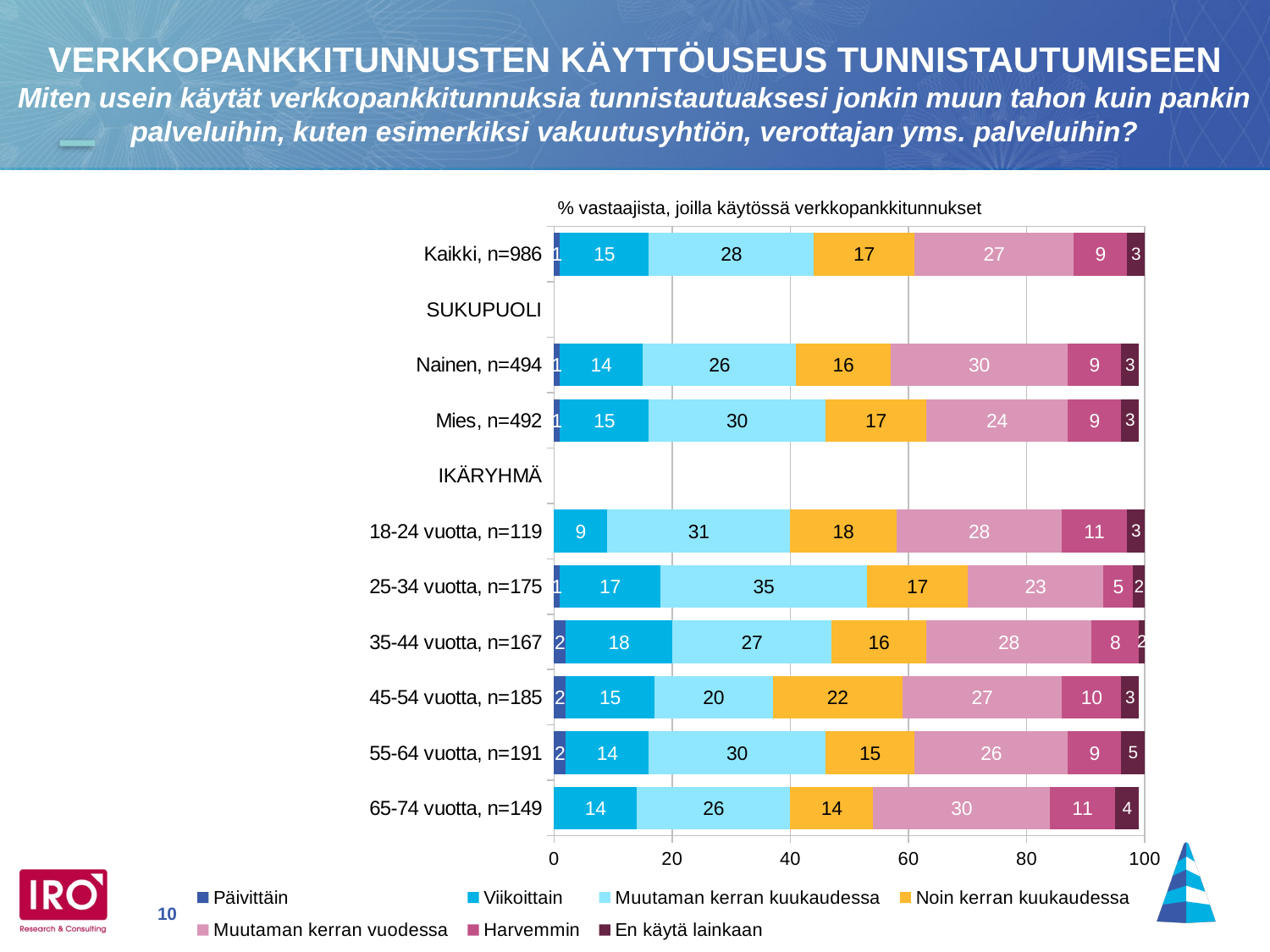
Which has the larger 'Muutaman kerran kuukaudessa' value, 'Nainen, n=494' or 'Mies, n=492'? Mies, n=492 Which group has the lowest value for 'Viikoittain'? 18-24 vuotta, n=119 What is the subtitle text shown above the chart? % vastaajista, joilla käytössä verkkopankkitunnukset What is the value for 'Muutaman kerran kuukaudessa' in the 'Kaikki, n=986' bar? 28 What is the value for 'Viikoittain' in the '65-74 vuotta, n=149' bar? 14 What kind of chart is shown on the slide? Stacked bar chart Which group has the highest value for 'En käytä lainkaan'? 55-64 vuotta, n=191 How many age groups (IKÄRYHMÄ) are shown in the chart? 6 What is the difference between the 'Muutaman kerran vuodessa' values for 'Nainen, n=494' and 'Mies, n=492'? 6 What is the value for 'Noin kerran kuukaudessa' in the '45-54 vuotta, n=185' bar? 22 How many series does the legend list? 7 Which group has the highest value for 'Muutaman kerran kuukaudessa'? 25-34 vuotta, n=175